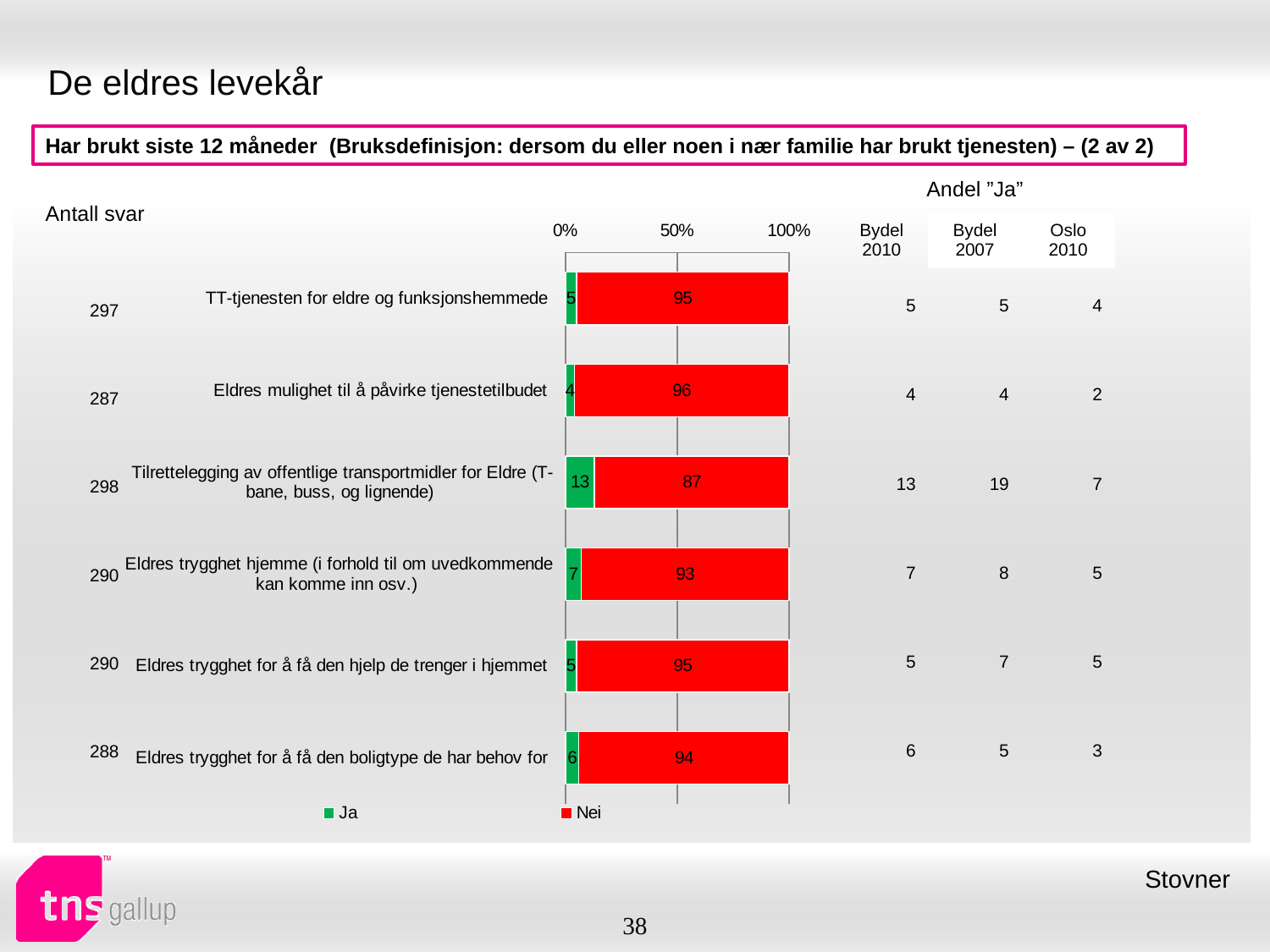
Which is larger: the "Ja" value for "Eldres trygghet hjemme (i forhold til om uvedkommende kan komme inn osv.)" or the "Ja" value for "Eldres trygghet for å få den boligtype de har behov for"? Eldres trygghet hjemme (i forhold til om uvedkommende kan komme inn osv.) What is the "Nei" value for "TT-tjenesten for eldre og funksjonshemmede"? 95 Is the "Nei" value for "Eldres trygghet for å få den hjelp de trenger i hjemmet" greater or less than 50%? greater What is the total of the stacked bar for "Eldres trygghet for å få den boligtype de har behov for"? 100 What is the "Nei" value for "Eldres trygghet hjemme (i forhold til om uvedkommende kan komme inn osv.)"? 93 Which category has the highest "Ja" value? Tilrettelegging av offentlige transportmidler for Eldre (T-bane, buss, og lignende) How many series does the legend list? 2 What is the difference between the "Nei" values for "Eldres mulighet til å påvirke tjenestetilbudet" and "Tilrettelegging av offentlige transportmidler for Eldre (T-bane, buss, og lignende)"? 9 What kind of chart is shown on the slide? Stacked bar chart What is the "Ja" value for "Tilrettelegging av offentlige transportmidler for Eldre (T-bane, buss, og lignende)"? 13 Which category has the lowest "Nei" value? Tilrettelegging av offentlige transportmidler for Eldre (T-bane, buss, og lignende) How many categories are shown in the chart? 6